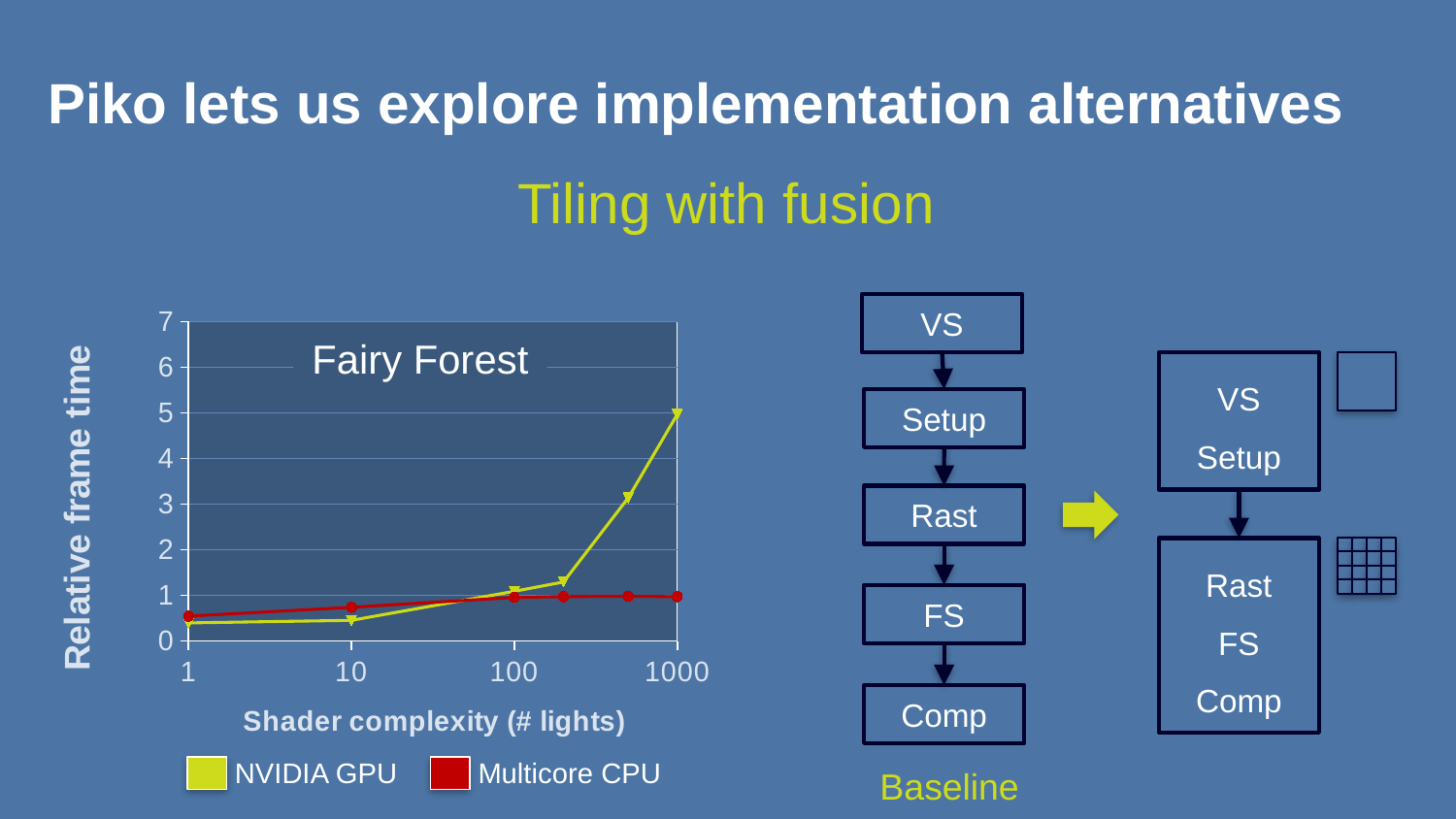
Does the NVIDIA GPU relative frame time rise or fall as shader complexity increases along the x axis? rise What kind of chart is shown on the slide? line chart What are the two series named in the chart legend? NVIDIA GPU and Multicore CPU What title is shown inside the chart's plot area? Fairy Forest Is the NVIDIA GPU value at 1000 lights greater or less than 4? greater How many tick labels are shown on the x axis of the chart? 4 How many series does the chart legend list? 2 Is the Multicore CPU value at 1000 lights greater or less than 2? less At 1 light, which series has the higher relative frame time, NVIDIA GPU or Multicore CPU? Multicore CPU Is the NVIDIA GPU value at 10 lights greater or less than 1? less At which shader complexity does the NVIDIA GPU series reach its highest relative frame time? 1000 At 1000 lights, which series has the higher relative frame time, NVIDIA GPU or Multicore CPU? NVIDIA GPU